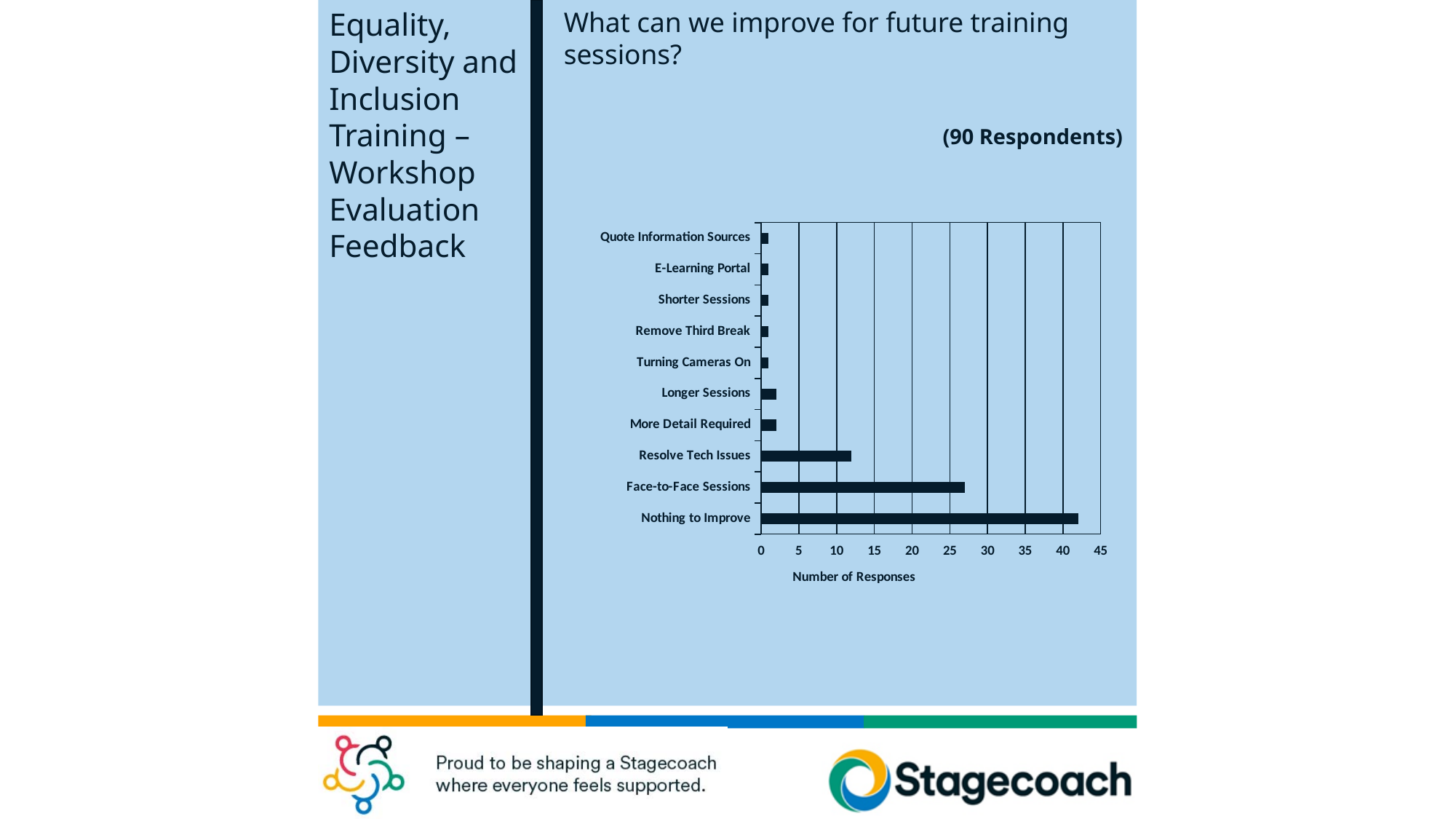
Is the value for Face-to-Face Sessions greater or less than 30? less Is the value for Nothing to Improve greater or less than 40? greater What kind of chart is shown on the slide? bar chart How many respondents does the chart heading say took part? 90 Is the value for Resolve Tech Issues greater or less than 10? greater Which category has the highest number of responses? Nothing to Improve How many categories are plotted on the chart? 10 Which has more responses, Face-to-Face Sessions or Resolve Tech Issues? Face-to-Face Sessions What is the label of the horizontal axis? Number of Responses